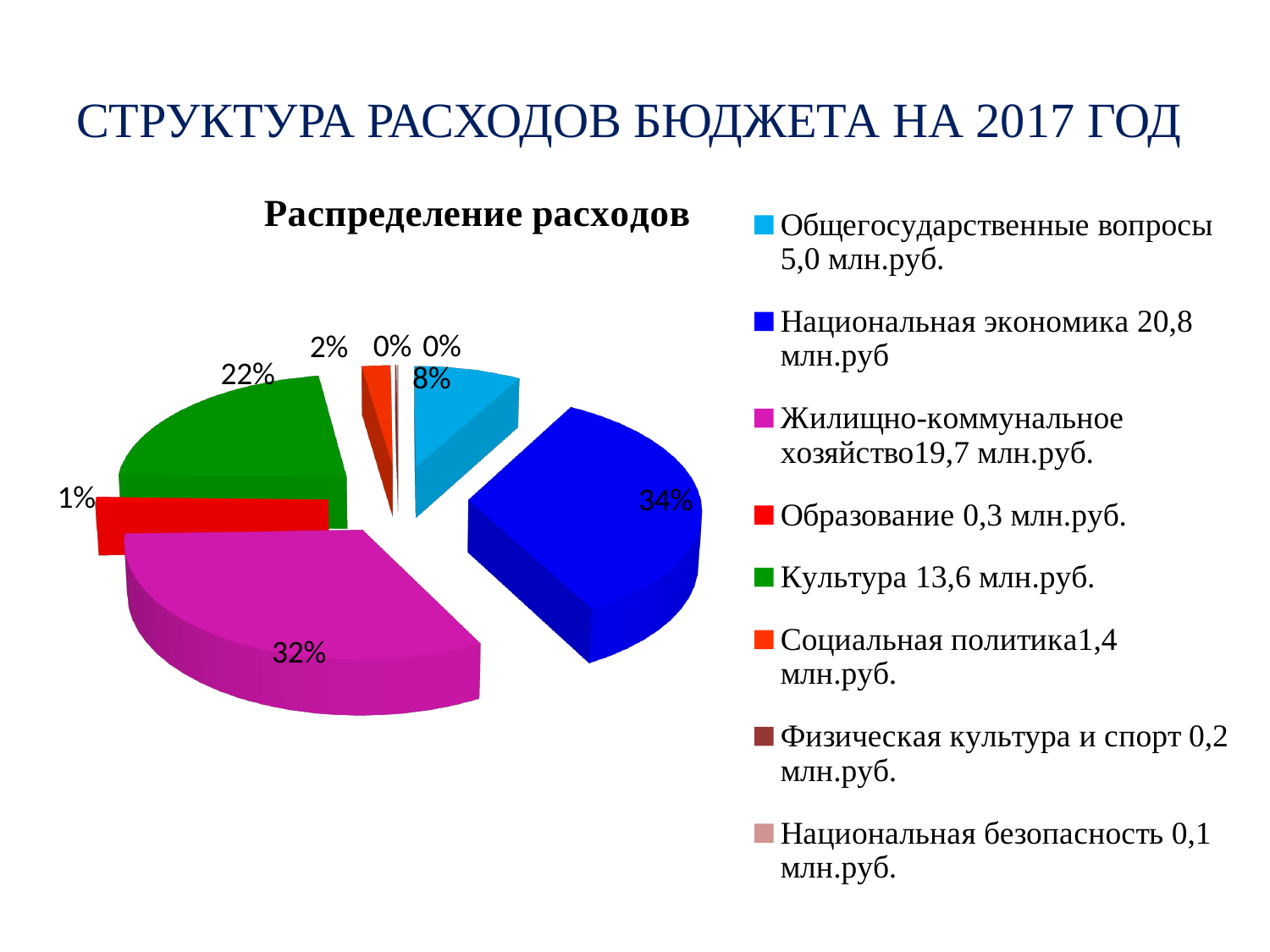
What share of the pie does Общегосударственные вопросы represent? 8% What share of the pie does Жилищно-коммунальное хозяйство represent? 32% What share of the pie does Культура represent? 22% Which is larger: the share for Национальная экономика or the share for Жилищно-коммунальное хозяйство? Национальная экономика What is the difference in percentage points between the share for Национальная экономика and the share for Культура? 12 What kind of chart is shown on the slide? pie chart Which category has the largest share of the pie? Национальная экономика What is the title of the chart? Распределение расходов What colour is the slice for Национальная экономика? blue How many slices does the pie chart have? 8 According to the legend, what amount is given for Культура? 13,6 млн.руб.